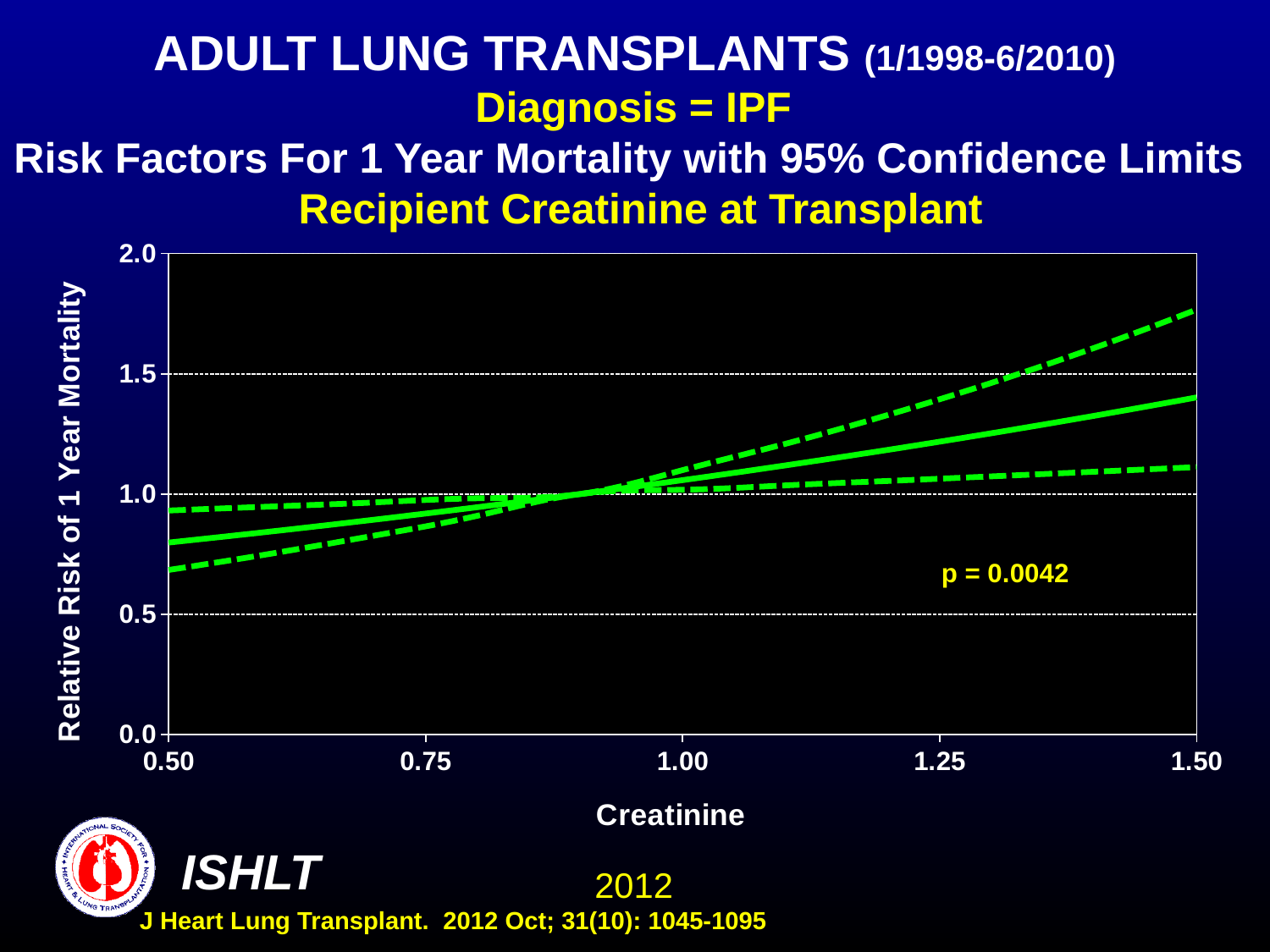
What kind of chart is shown on the slide? line chart Is the relative risk (solid line) at a creatinine of 1.50 greater or less than 1.5? less What p-value is shown on the chart? p = 0.0042 How many lines are plotted on the chart? 3 What is the label of the x axis? Creatinine Does the relative risk of 1 year mortality rise or fall as creatinine increases from 0.50 to 1.50? rise Is the relative risk (solid line) at a creatinine of 1.50 greater or less than 1.0? greater Is the lower 95% confidence limit at a creatinine of 0.50 greater or less than 0.5? greater